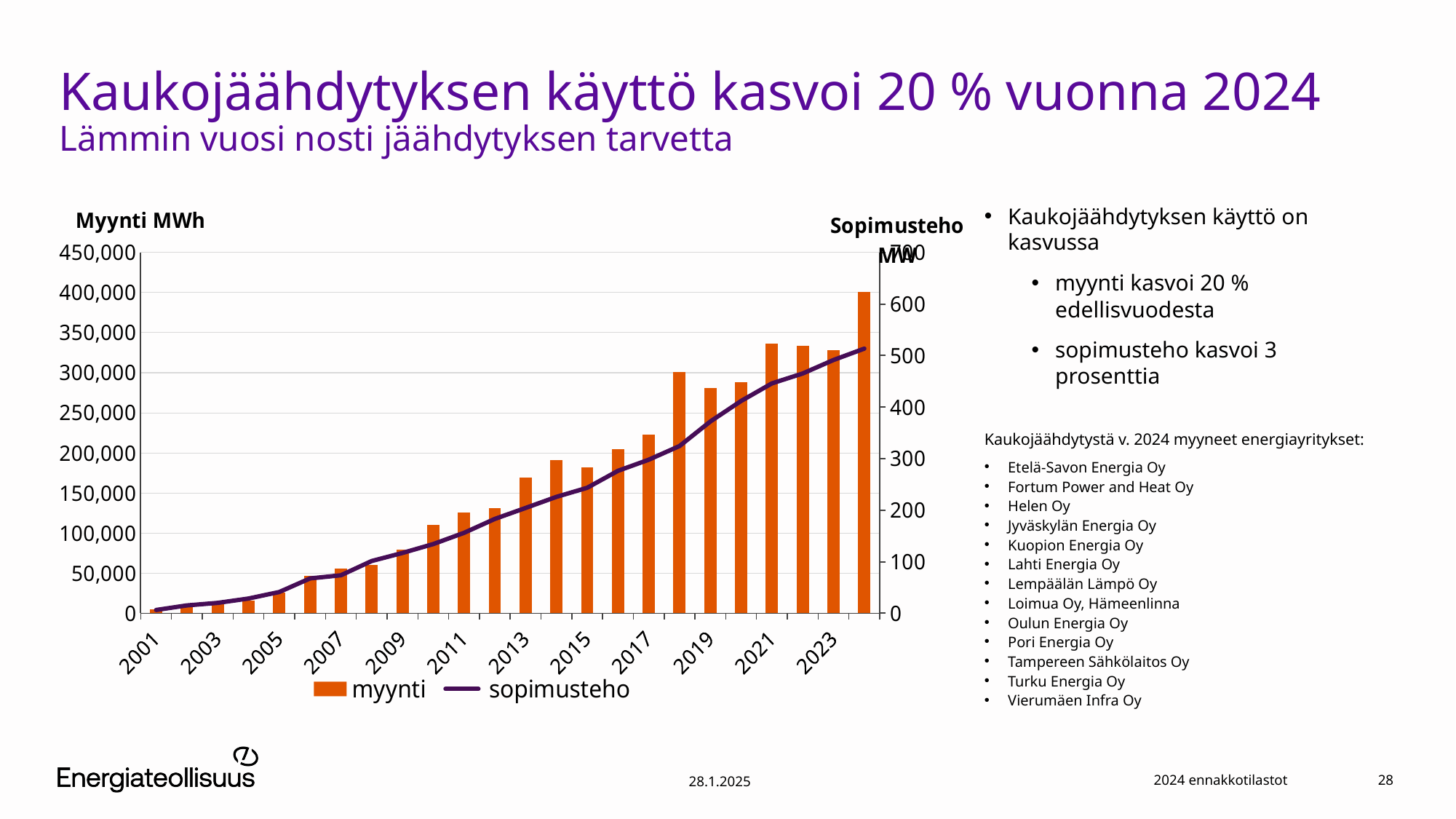
What are the two series named in the legend? myynti and sopimusteho Is the myynti value for 2024 greater or less than 350,000 MWh? greater Which year has the highest myynti bar? 2024 Which year has the lowest myynti bar? 2001 What kind of chart is shown on the slide? A bar chart combined with a line chart How many series does the chart legend list? 2 Is the myynti value for 2019 greater or less than 300,000 MWh? less Does the sopimusteho line generally rise or fall from 2001 to 2024? rise Is the sopimusteho value for 2021 greater or less than 400 MW? greater What is the title of the left vertical axis? Myynti MWh How many years (bars) are plotted in the chart? 24 Which year has the larger myynti bar, 2019 or 2021? 2021